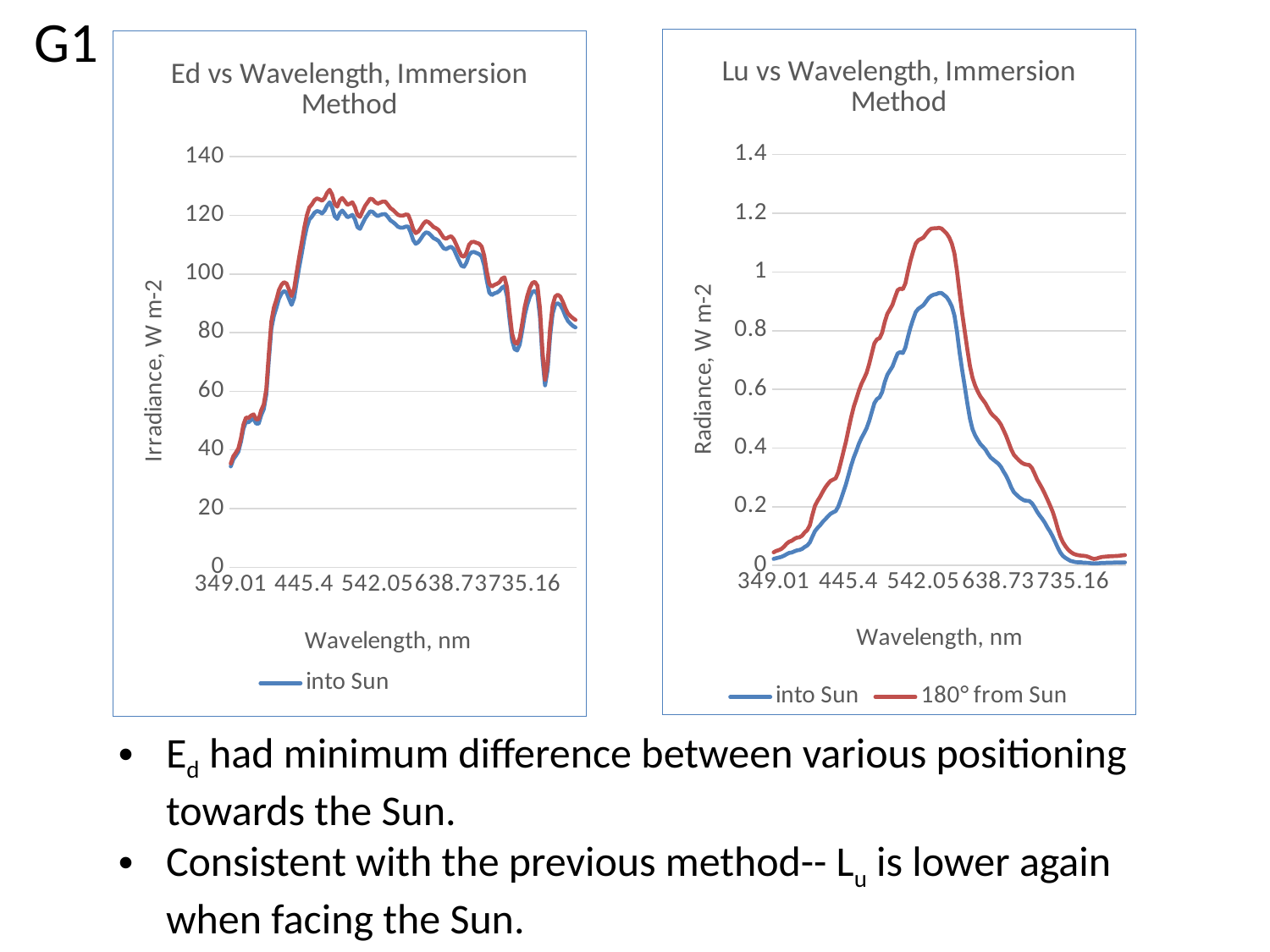
What kind of chart is the 'Ed vs Wavelength, Immersion Method' chart? line chart In the 'Lu vs Wavelength, Immersion Method' chart, is the peak value of the '180° from Sun' series greater or less than 1? greater In the 'Lu vs Wavelength, Immersion Method' chart, do the values rise or fall from 542.05 nm to 735.16 nm? fall In the 'Ed vs Wavelength, Immersion Method' chart, is the irradiance at the lowest wavelength (349.01 nm) greater or less than 40? less In the 'Ed vs Wavelength, Immersion Method' chart, do the values rise or fall from 349.01 nm to 445.4 nm? rise In the 'Lu vs Wavelength, Immersion Method' chart, is the peak value of the 'into Sun' series greater or less than 1? less In the 'Lu vs Wavelength, Immersion Method' chart, which series reaches the higher peak value? 180° from Sun What kind of chart is the 'Lu vs Wavelength, Immersion Method' chart? line chart What is the x-axis title of the 'Ed vs Wavelength, Immersion Method' chart? Wavelength, nm What is the y-axis title of the 'Lu vs Wavelength, Immersion Method' chart? Radiance, W m-2 In the 'Lu vs Wavelength, Immersion Method' chart, how many series does the legend list? 2